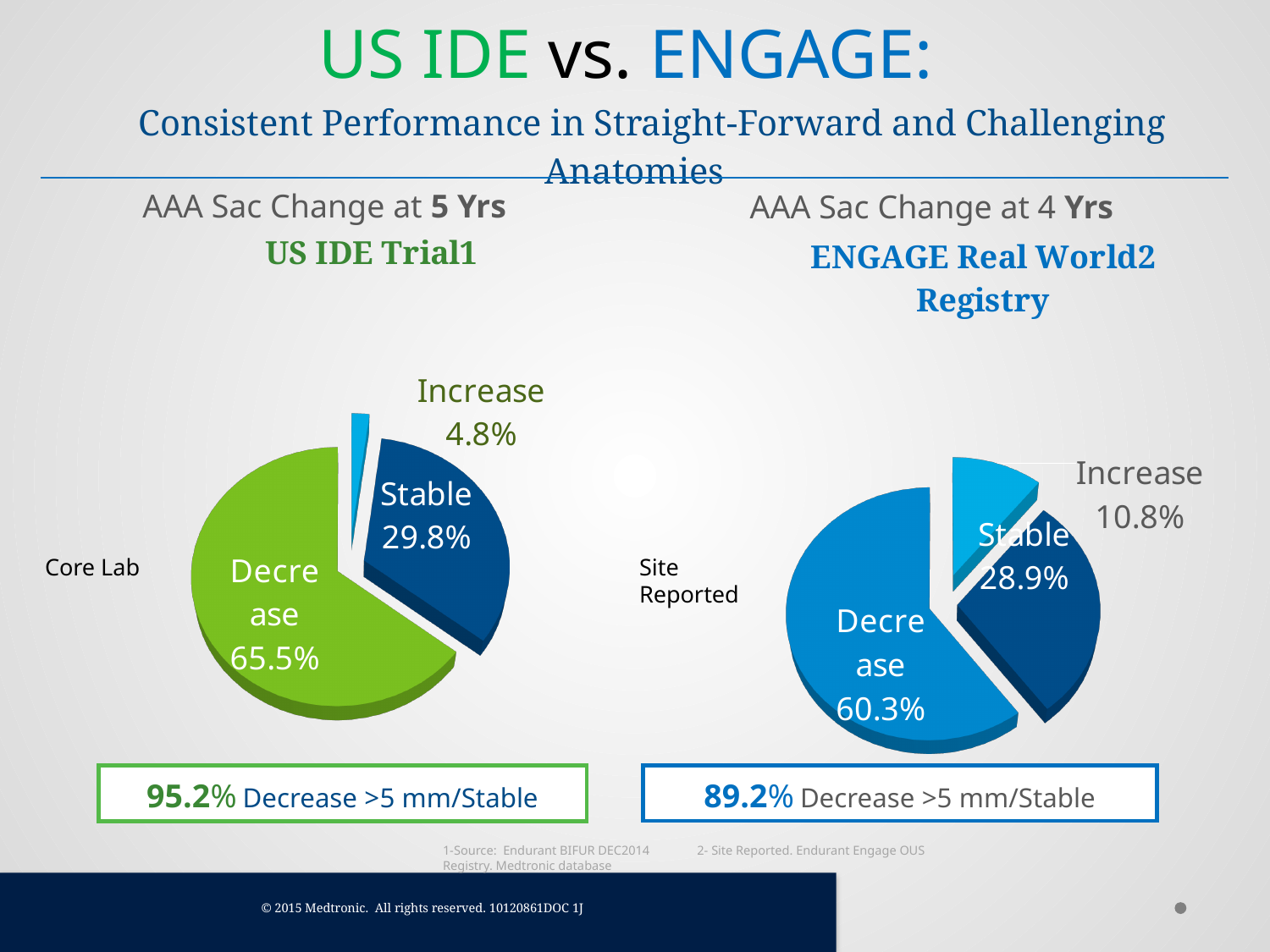
What is the difference between the Decrease percentage in the US IDE Trial chart and the Decrease percentage in the ENGAGE Real World Registry chart? 5.2% What colour is the Decrease slice in the US IDE Trial pie chart on the left? Green What kind of chart is used for the ENGAGE Real World Registry data on the right? Pie chart In the US IDE Trial pie chart on the left, which category has the largest slice? Decrease In the US IDE Trial pie chart on the left, what is the combined share of the Decrease and Stable slices? 95.3% How many slices does the US IDE Trial pie chart on the left have? 3 Which chart shows a larger Increase percentage, the US IDE Trial chart on the left or the ENGAGE Real World Registry chart on the right? ENGAGE Real World Registry In the US IDE Trial pie chart on the left, what percentage is labelled for Stable? 29.8% In the US IDE Trial pie chart on the left, what percentage is labelled for Decrease? 65.5% In the ENGAGE Real World Registry pie chart on the right, what percentage is labelled for Increase? 10.8% In the ENGAGE Real World Registry pie chart on the right, what percentage is labelled for Decrease? 60.3% In the ENGAGE Real World Registry pie chart on the right, which category has the smallest slice? Increase